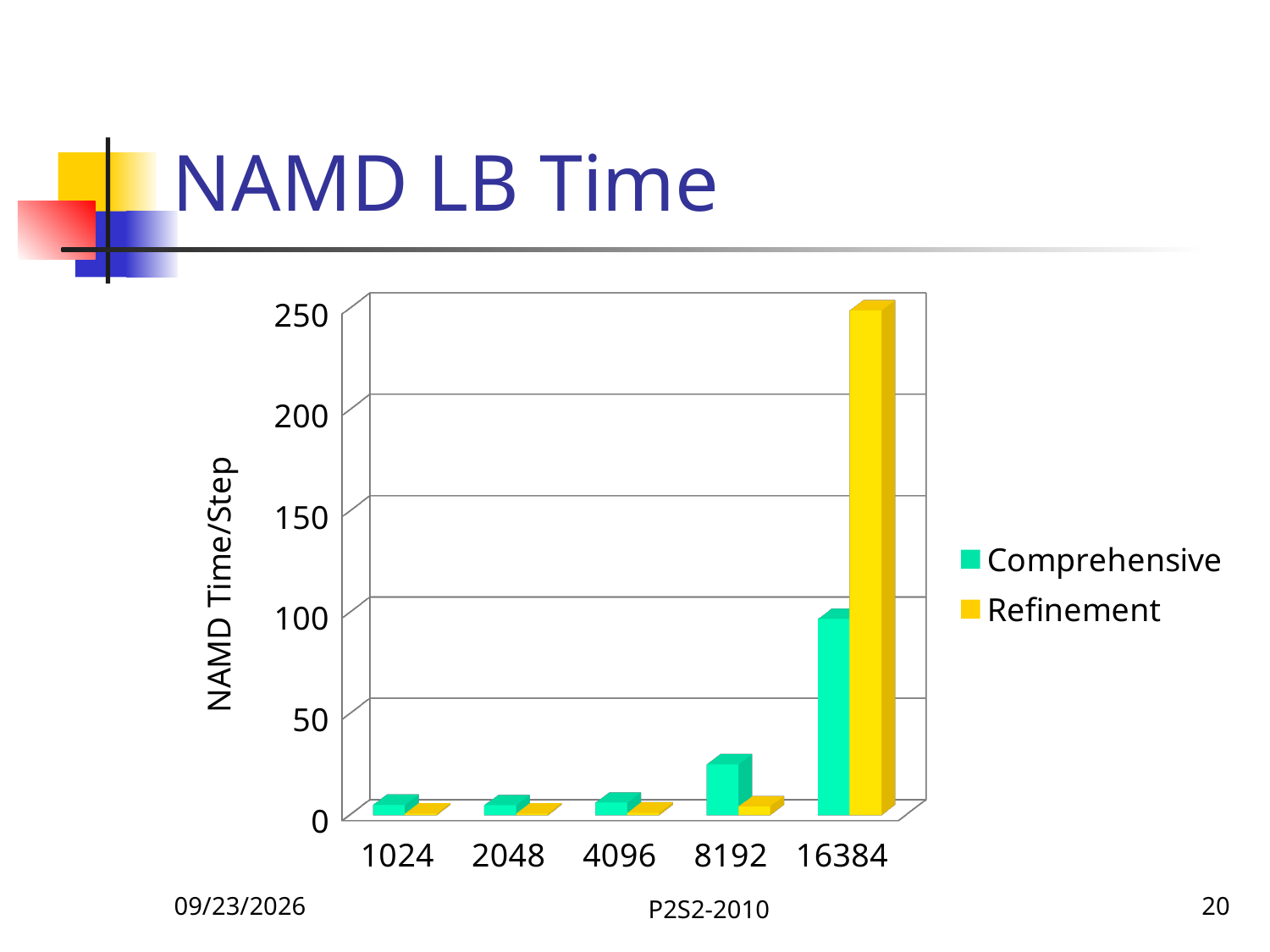
What kind of chart is shown on the slide? bar chart Do the Comprehensive values rise or fall as the x axis goes from 1024 to 16384? rise At 16384, which series has the larger value, Comprehensive or Refinement? Refinement At 8192, which series has the larger value, Comprehensive or Refinement? Comprehensive Is the Refinement value for 16384 greater or less than 200? greater Which category has the highest Comprehensive value? 16384 Is the Comprehensive value for 8192 greater or less than 50? less How many categories are shown on the x axis? 5 What is the label on the vertical axis of the chart? NAMD Time/Step How many series does the legend list? 2 Which category has the highest Refinement value? 16384 Is the Comprehensive value for 16384 greater or less than 50? greater